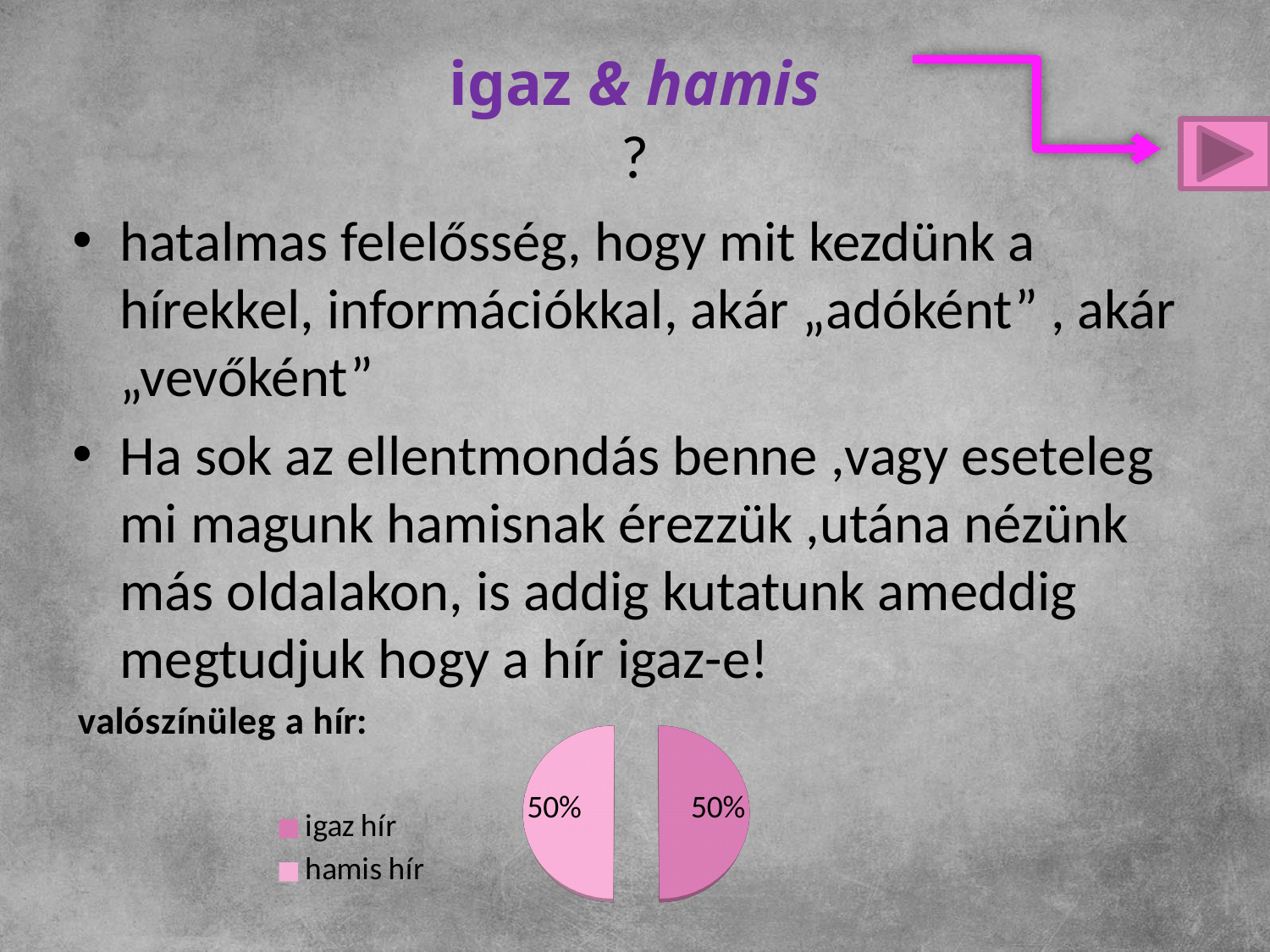
How many entries does the legend of the pie chart list? 2 What value is printed on the slice for "igaz hír"? 50% What share of the pie chart does "hamis hír" take? 50% What kind of chart is shown at the bottom of the slide? pie chart How many slices does the pie chart have? 2 What is the difference between the "igaz hír" and "hamis hír" slices? 0% What label appears above the pie chart's legend? valószínüleg a hír: What share of the pie chart does "igaz hír" take? 50% What value is printed on the slice for "hamis hír"? 50% What are the two legend entries of the pie chart? igaz hír, hamis hír